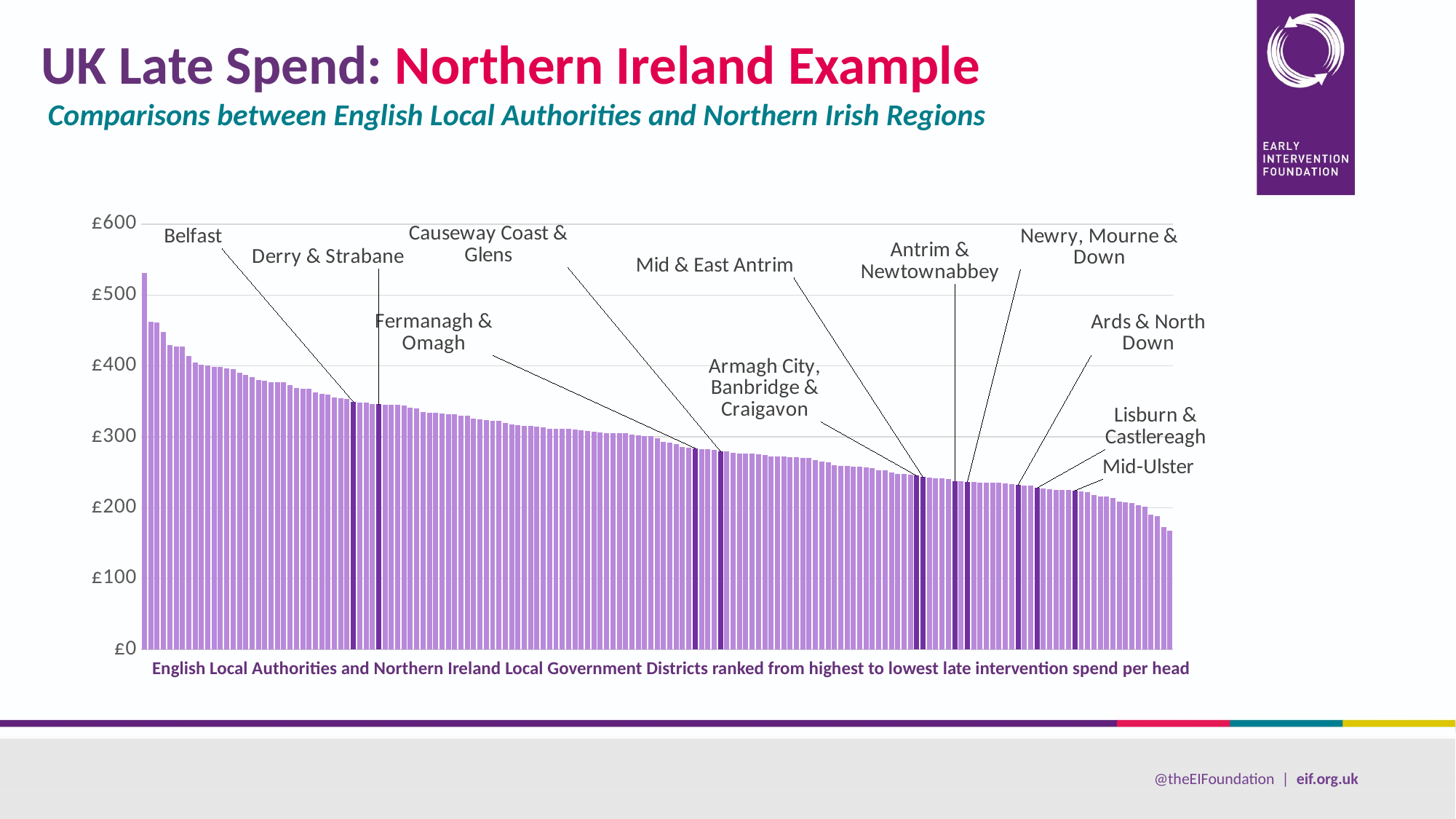
What does the caption below the x axis say the bars are ranked by? late intervention spend per head, from highest to lowest Which has the higher late intervention spend per head, Belfast or Mid-Ulster? Belfast Is the value for Mid-Ulster greater or less than £200? greater Do the bar values rise or fall from left to right along the x axis? fall How many Northern Ireland Local Government Districts are labelled on the chart? 11 What kind of chart is shown on the slide? bar chart Is the value for Belfast greater or less than £400? less Is the value for Antrim & Newtownabbey greater or less than £300? less Which has the higher late intervention spend per head, Derry & Strabane or Ards & North Down? Derry & Strabane